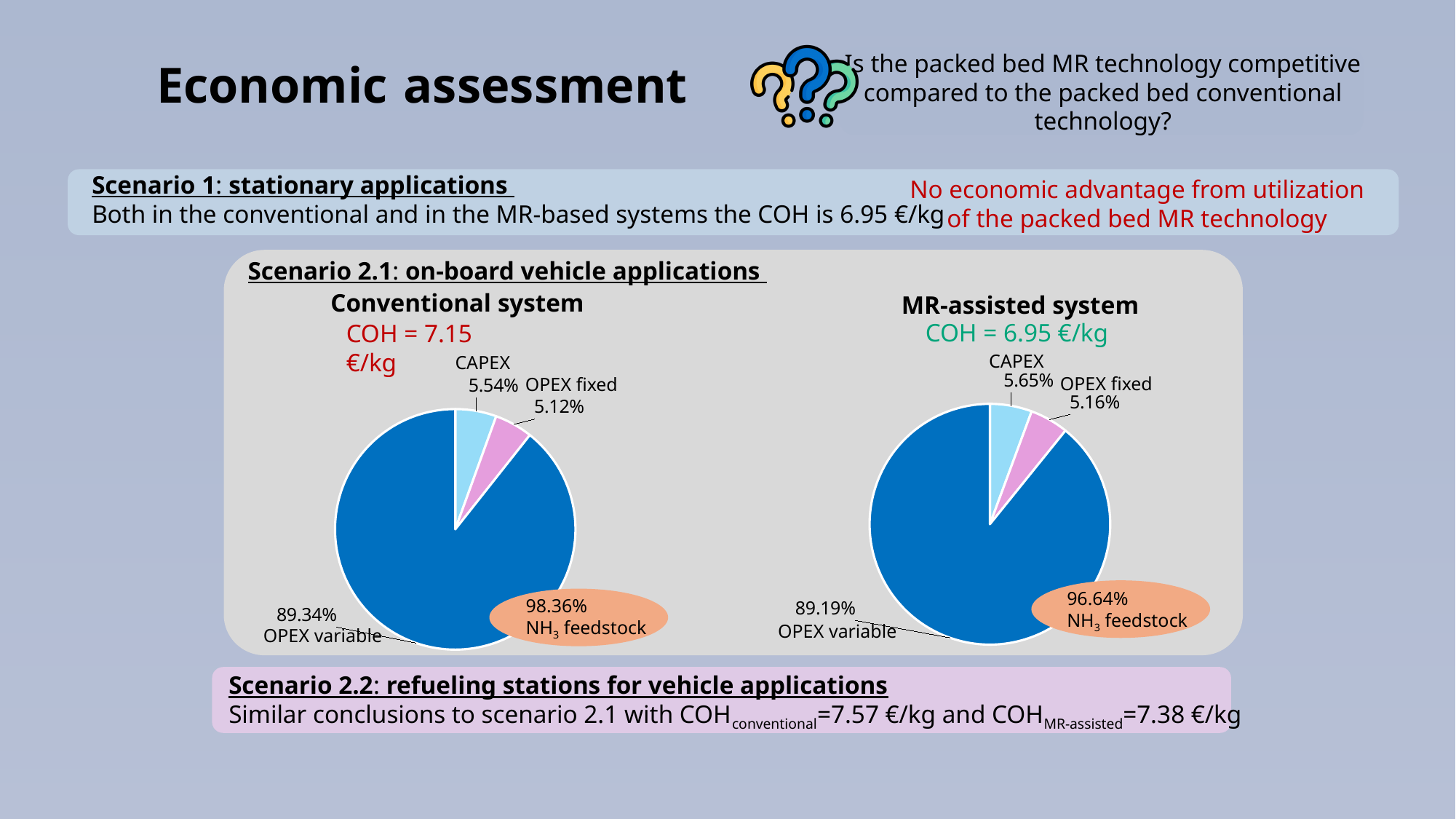
In the Conventional system pie chart, what share does CAPEX have? 5.54% In the Conventional system pie chart, what share does OPEX variable have? 89.34% In the Conventional system pie chart, what is the difference between the CAPEX share and the OPEX fixed share? 0.42% In the MR-assisted system pie chart, what share does CAPEX have? 5.65% In the Conventional system pie chart, what share does OPEX fixed have? 5.12% In the MR-assisted system pie chart, what share does OPEX fixed have? 5.16% In the MR-assisted system pie chart, which slice is the largest? OPEX variable What kind of chart is used for the Conventional system? pie chart In the MR-assisted system pie chart, what share does OPEX variable have? 89.19% Which is larger: the CAPEX share in the Conventional system pie chart or the CAPEX share in the MR-assisted system pie chart? MR-assisted system How many slices does the Conventional system pie chart have? 3 In the Conventional system pie chart, which slice is the smallest? OPEX fixed